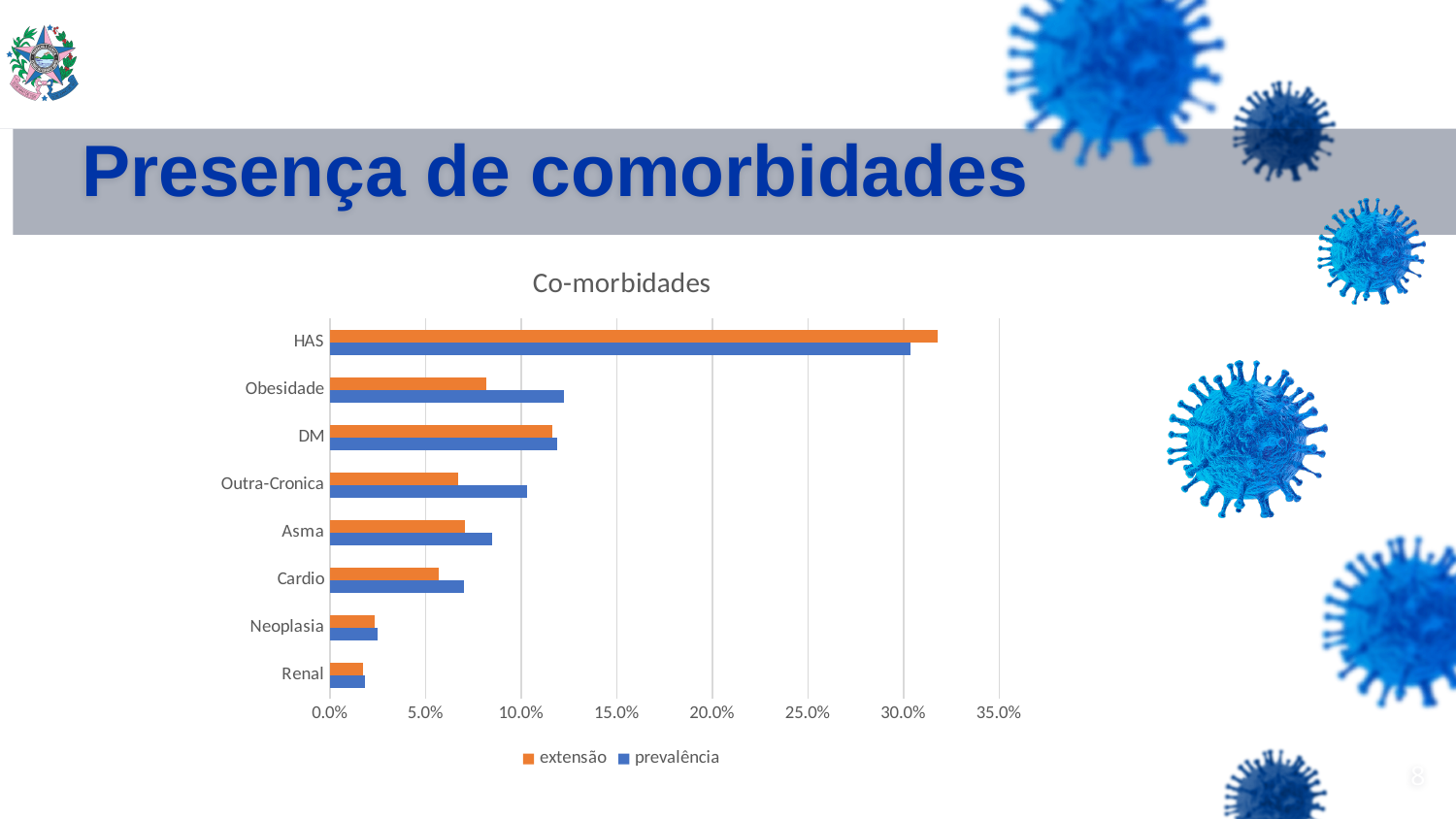
What is the title of the chart on the slide? Co-morbidades Is the prevalência value for Cardio greater or less than 5.0%? greater Which category has the lowest extensão value in the Co-morbidades chart? Renal How many comorbidity categories are plotted in the Co-morbidades chart? 8 Which series is shown in orange in the Co-morbidades chart? extensão Is the prevalência value for Obesidade greater or less than 10.0%? greater How many series does the legend of the Co-morbidades chart list? 2 Is the extensão value for Outra-Cronica greater or less than 10.0%? less What kind of chart is shown on the slide? bar chart For Obesidade, which is larger: the extensão value or the prevalência value? prevalência Which category has the highest prevalência value in the Co-morbidades chart? HAS